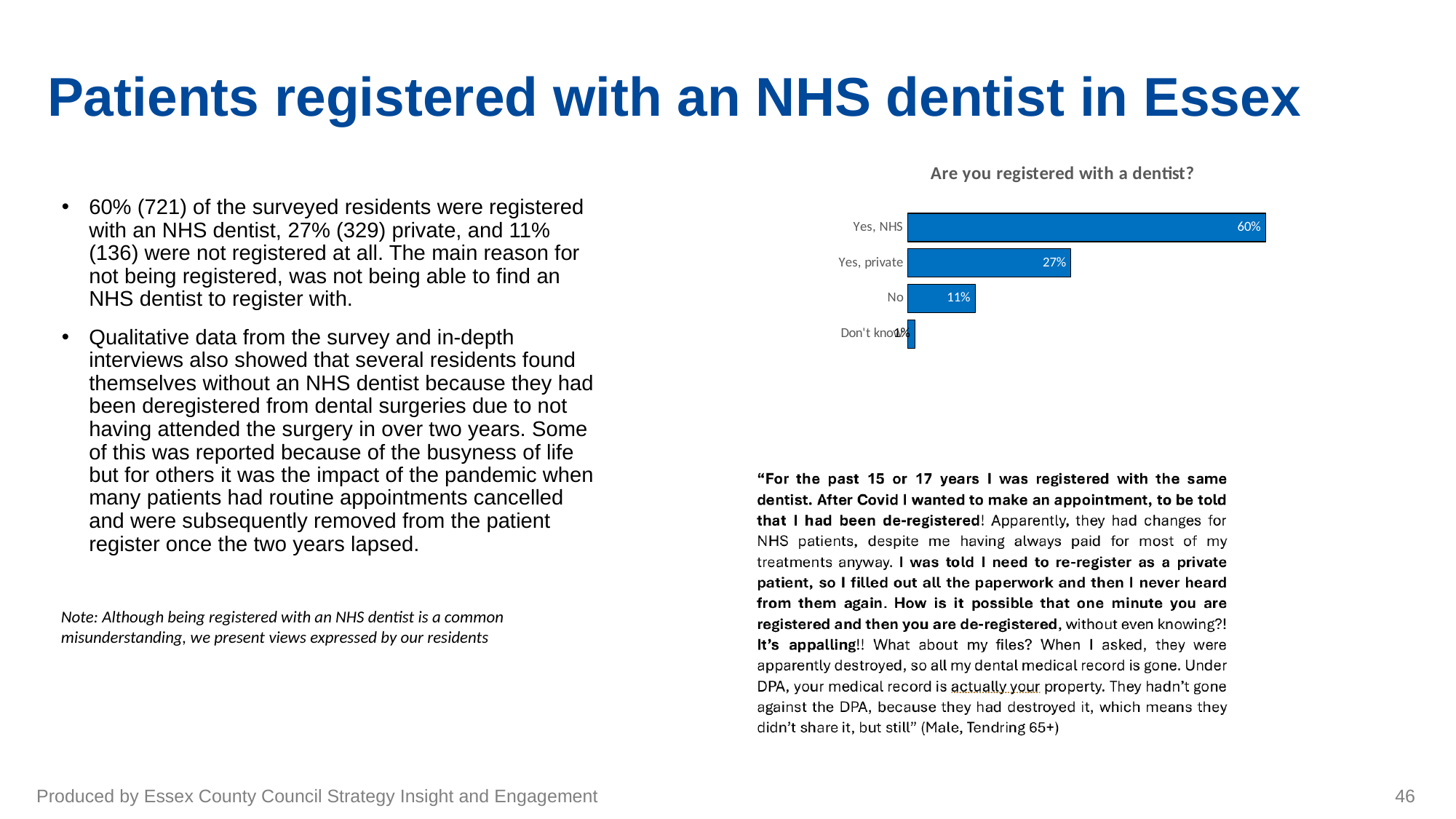
What is the difference in percentage points between 'Yes, private' and 'No'? 16 percentage points What percentage of respondents answered 'Don't know'? 1% What percentage of respondents answered 'Yes, NHS' in the 'Are you registered with a dentist?' chart? 60% What percentage of respondents answered 'No' to being registered with a dentist? 11% Which response category has the highest percentage in the chart? Yes, NHS What is the title of the chart on the slide? Are you registered with a dentist? Which is larger: the percentage for 'Yes, private' or for 'No'? Yes, private How many response categories are shown in the chart? 4 What type of chart is used to show the dentist registration responses? Bar chart What percentage of respondents answered 'Yes, private'? 27% Which response category has the lowest percentage in the chart? Don't know What is the difference in percentage points between 'Yes, NHS' and 'Yes, private'? 33 percentage points